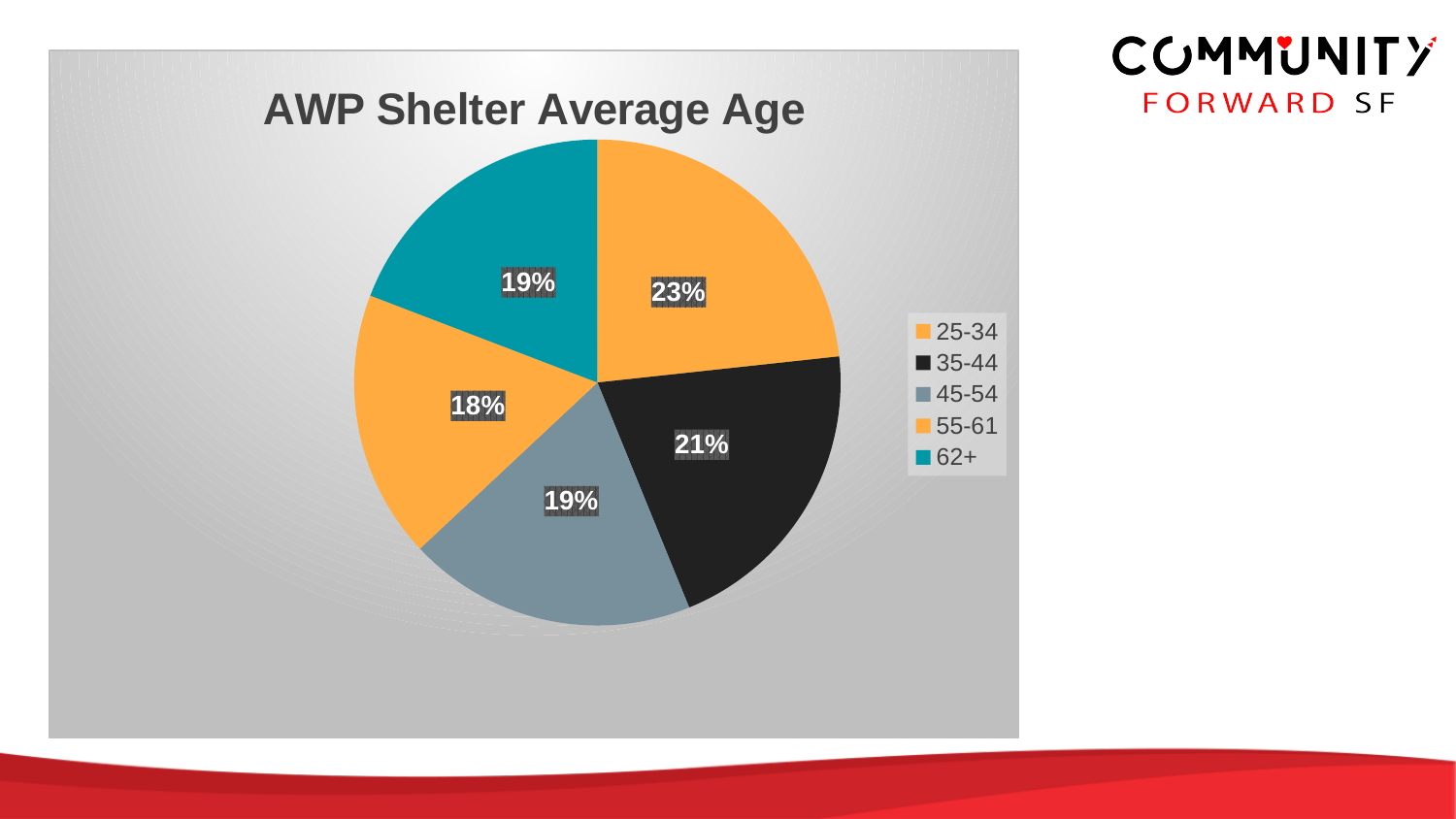
Which has a larger share, the 25-34 group or the 35-44 group? 25-34 How many age groups does the legend list? 5 What is the difference in percentage points between the 25-34 group and the 55-61 group? 5 percentage points What percentage of the pie is the 62+ age group? 19% What percentage of the pie is the 35-44 age group? 21% What percentage of the pie is the 55-61 age group? 18% Which age group has the smallest share of the pie? 55-61 What is the title of the chart? AWP Shelter Average Age What percentage of the pie is the 45-54 age group? 19% Which age group has the largest share of the pie? 25-34 What type of chart is shown on the slide? pie chart What percentage of the pie is the 25-34 age group? 23%